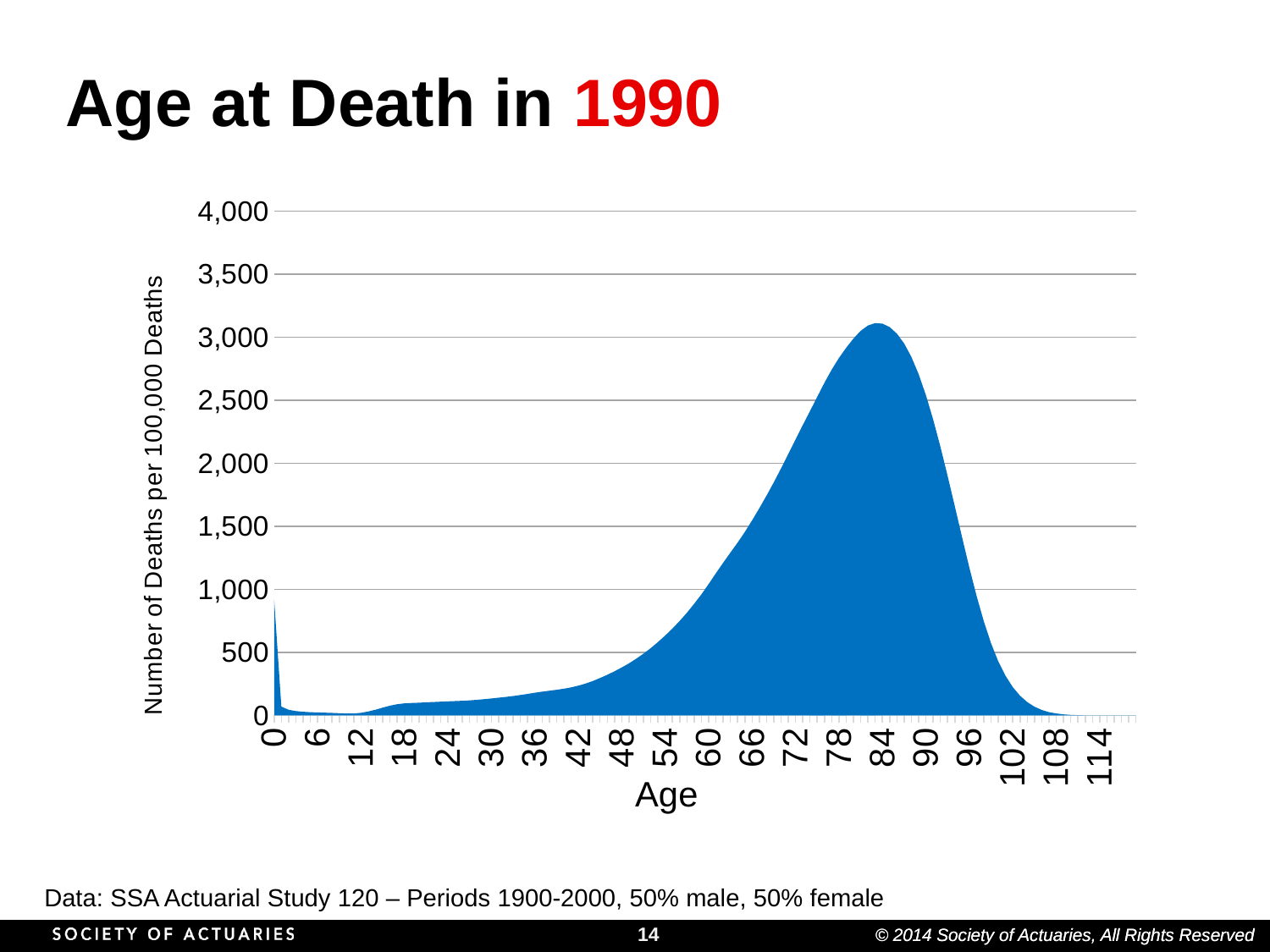
Which has the larger value, age 78 or age 48? age 78 Is the value at age 30 greater or less than 500? less Is the value at age 72 greater or less than 1,500? greater Do the values rise or fall as age increases from 84 to 108? fall Is the value at age 0 greater or less than 500? greater Do the values rise or fall as age increases from 48 to 84? rise What is the title of the slide's chart? Age at Death in 1990 What is the label of the y axis? Number of Deaths per 100,000 Deaths What kind of chart is shown on the slide? area chart